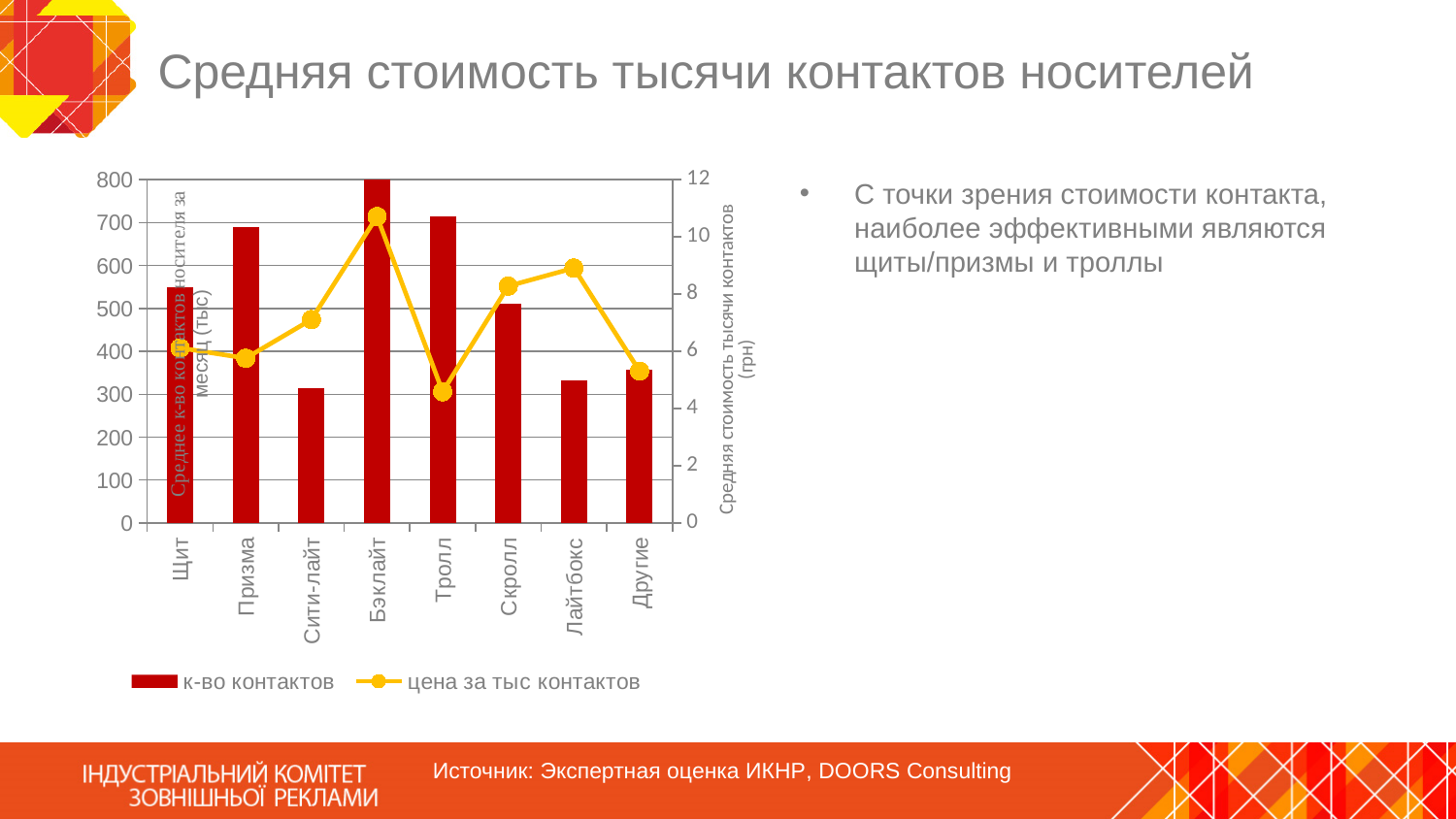
Is the цена за тыс контактов value for Лайтбокс greater or less than 8? greater What type of chart is shown on the slide? Combined bar and line chart How many series does the chart legend list? 2 Which category has the highest bar for к-во контактов? Бэклайт How many categories are shown on the x axis of the chart? 8 What is the title of the chart on the slide? Средняя стоимость тысячи контактов носителей Which has the larger к-во контактов bar, Призма or Скролл? Призма Is the к-во контактов value for Сити-лайт greater or less than 400? less Which category has the highest value on the цена за тыс контактов line? Бэклайт Is the цена за тыс контактов value for Тролл greater or less than 6? less Which category has the lowest value on the цена за тыс контактов line? Тролл